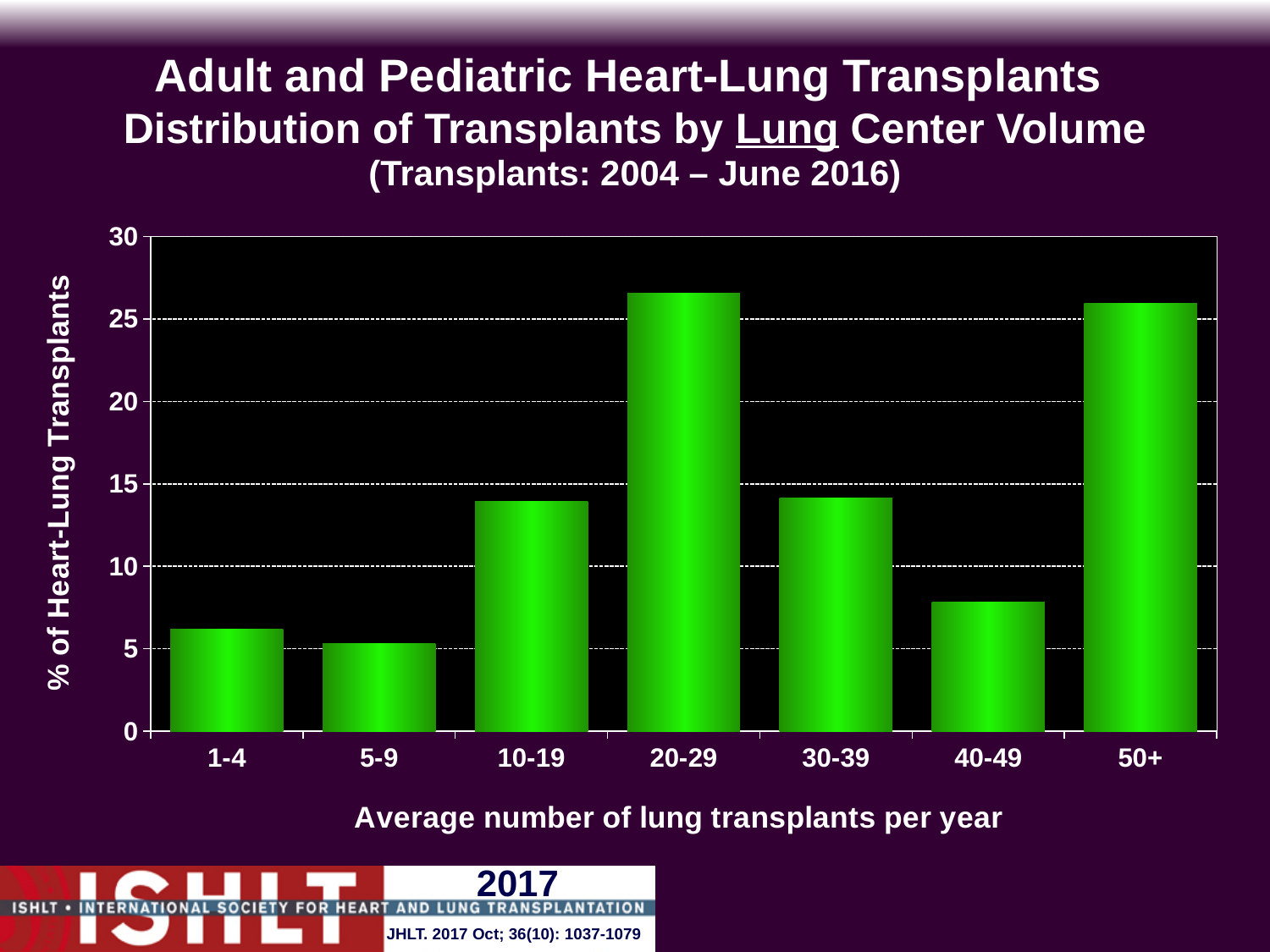
What is the label of the y axis? % of Heart-Lung Transplants Is the value for the 10-19 category greater or less than 15? less What kind of chart is shown on the slide? bar chart How many center volume categories are shown on the x axis? 7 Is the value for the 1-4 category greater or less than 5? greater What is the label of the x axis? Average number of lung transplants per year Which has a higher percentage of heart-lung transplants, the 40-49 category or the 1-4 category? 40-49 Is the value for the 20-29 category greater or less than 25? greater Which has a higher percentage of heart-lung transplants, the 20-29 category or the 30-39 category? 20-29 Which center volume category has the lowest percentage of heart-lung transplants? 5-9